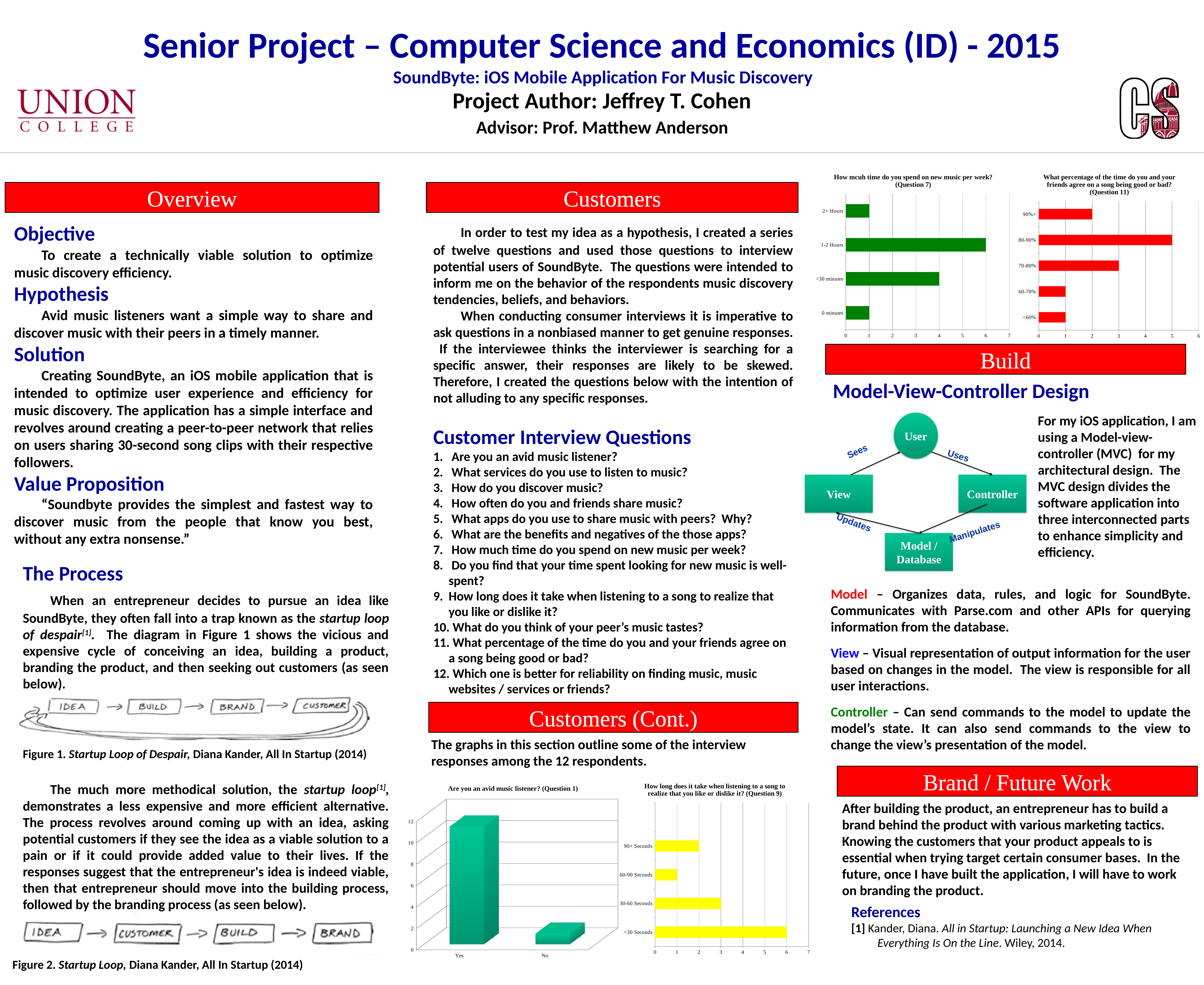
In the chart 'Are you an avid music listener? (Question 1)', is the value for 'Yes' greater or less than 8? greater In the chart 'What percentage of the time do you and your friends agree on a song being good or bad? (Question 11)', which category has the highest value? 80-90% In the chart 'How mcuh time do you spend on new music per week? (Question 7)', which category has the highest value? 1-2 Hours In the chart 'What percentage of the time do you and your friends agree on a song being good or bad? (Question 11)', what is the value for '70-80%'? 3 In the chart 'How long does it take when listening to a song to realize that you like or dislike it? (Question 9)', which category has the highest value? <30 Seconds In the chart 'What percentage of the time do you and your friends agree on a song being good or bad? (Question 11)', is the value for '80-90%' greater or less than 4? greater In the chart 'How mcuh time do you spend on new music per week? (Question 7)', is the value for '1-2 Hours' greater or less than 5? greater How many categories are shown in the chart 'How mcuh time do you spend on new music per week? (Question 7)'? 4 How many categories are shown in the chart 'What percentage of the time do you and your friends agree on a song being good or bad? (Question 11)'? 5 What kind of chart is 'How long does it take when listening to a song to realize that you like or dislike it? (Question 9)'? bar chart In the chart 'How mcuh time do you spend on new music per week? (Question 7)', what is the value for '<30 minutes'? 4 In the chart 'Are you an avid music listener? (Question 1)', which category is larger, 'Yes' or 'No'? Yes